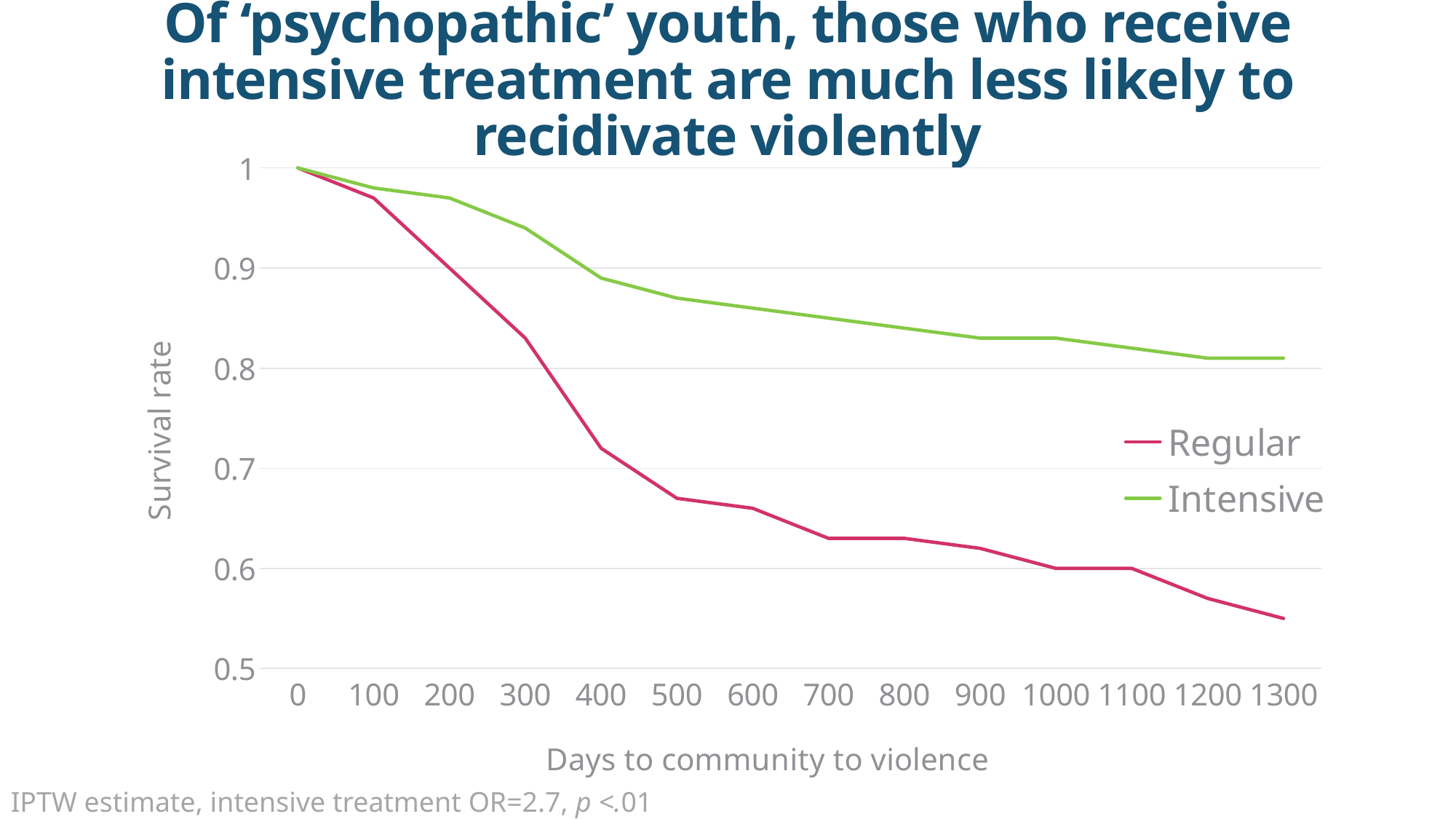
Is the survival rate for the Intensive series at day 700 greater or less than 0.8? greater Is the survival rate for the Regular series at day 1300 greater or less than 0.6? less What is the survival rate for the Regular series at day 0? 1 How many series does the legend list? 2 What is the survival rate for the Intensive series at day 0? 1 At day 1300, which series has the higher survival rate, Regular or Intensive? Intensive Is the survival rate for the Intensive series at day 500 greater or less than 0.9? less Do the survival rates rise or fall as days to community to violence increase? Fall What is the label of the y axis? Survival rate What are the two series named in the legend? Regular and Intensive What kind of chart is shown on the slide? Line chart